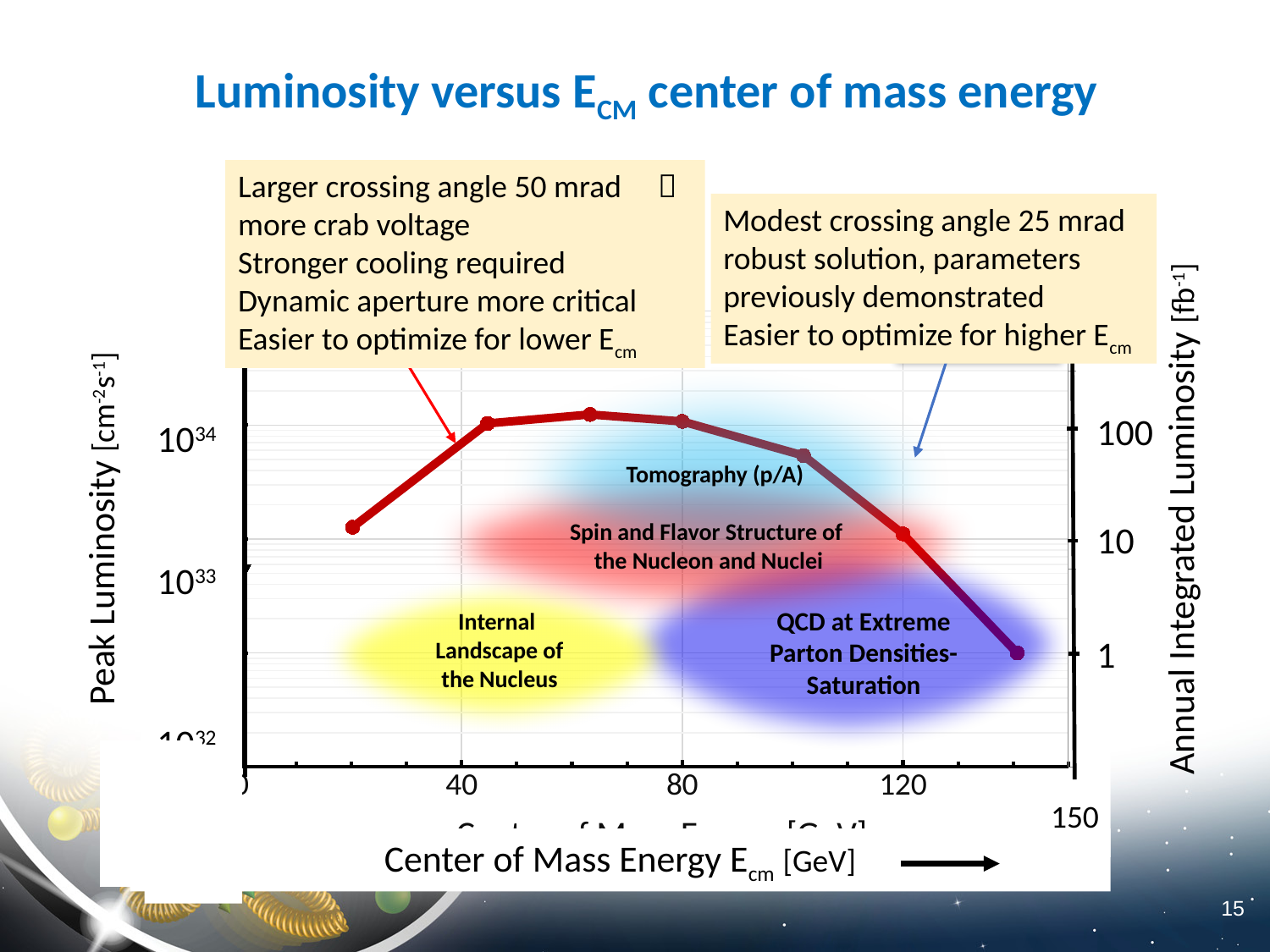
How many data points are plotted on the luminosity curve? 7 Is the peak luminosity at the rightmost point (near 140 GeV) greater or less than 10^33 cm-2s-1? less Which has the higher peak luminosity: the point near 20 GeV or the point near 140 GeV? the point near 20 GeV Is the annual integrated luminosity at 120 GeV greater or less than 100 fb-1? less Which plotted point has the lowest peak luminosity? the rightmost point, near 140 GeV What is the title of the slide's chart? Luminosity versus ECM center of mass energy What kind of chart is shown on the slide? line chart How does peak luminosity change as center of mass energy increases from 20 GeV to 140 GeV? rises then falls Is the peak luminosity at 80 GeV greater or less than 10^33 cm-2s-1? greater What quantity is labelled on the left vertical axis? Peak Luminosity [cm-2s-1]